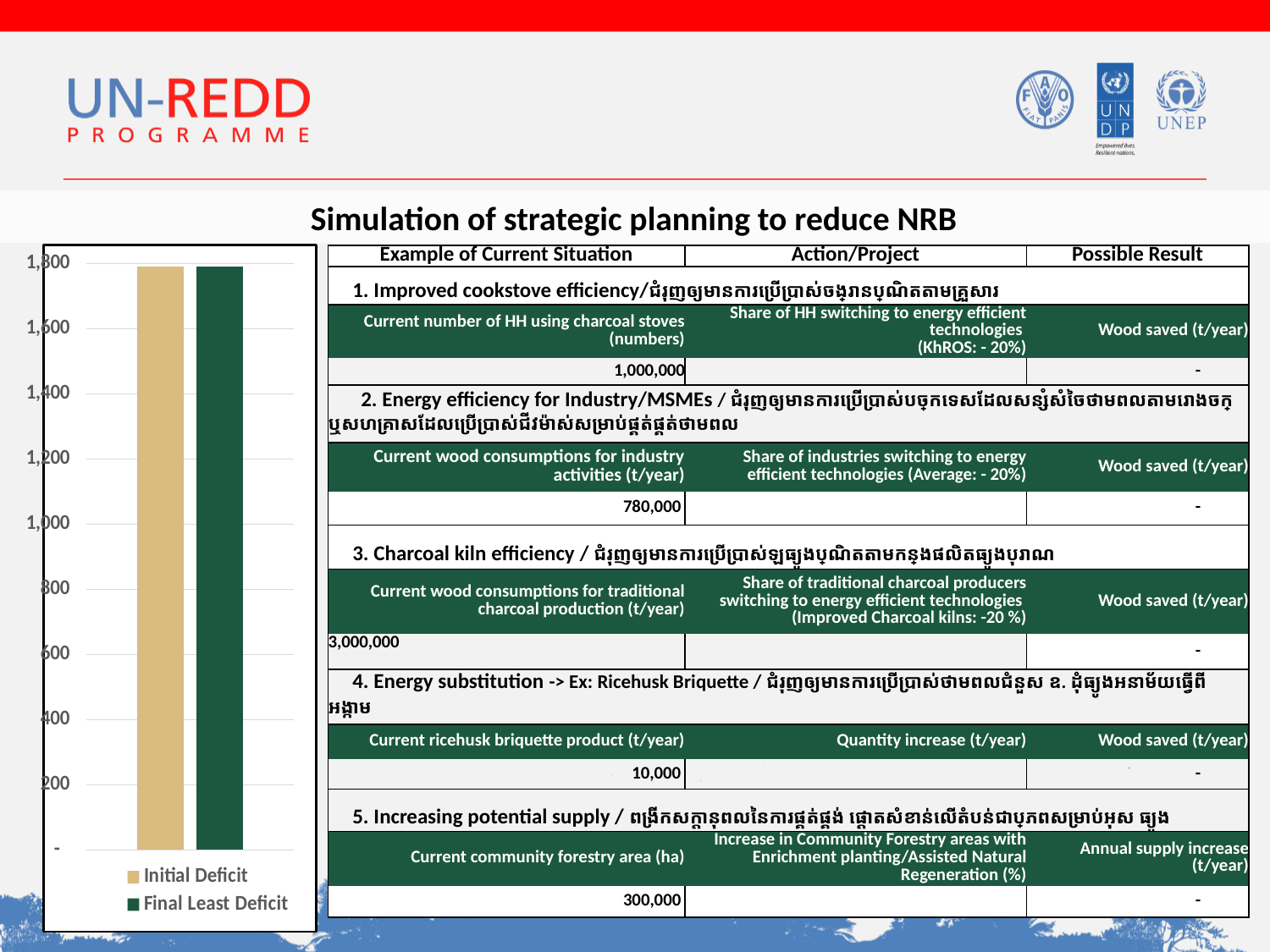
How many bars are plotted in the bar chart? 2 Is the value for Final Least Deficit greater or less than 1,400? greater What are the two series named in the legend of the bar chart? Initial Deficit and Final Least Deficit What is the highest tick value shown on the y axis of the bar chart? 1,800 Is the value for Final Least Deficit greater or less than 1,600? greater What kind of chart is shown on the left of the slide? bar chart Which series in the bar chart is shown in dark green? Final Least Deficit Is the value for Initial Deficit greater or less than 1,000? greater How many series does the legend of the bar chart list? 2